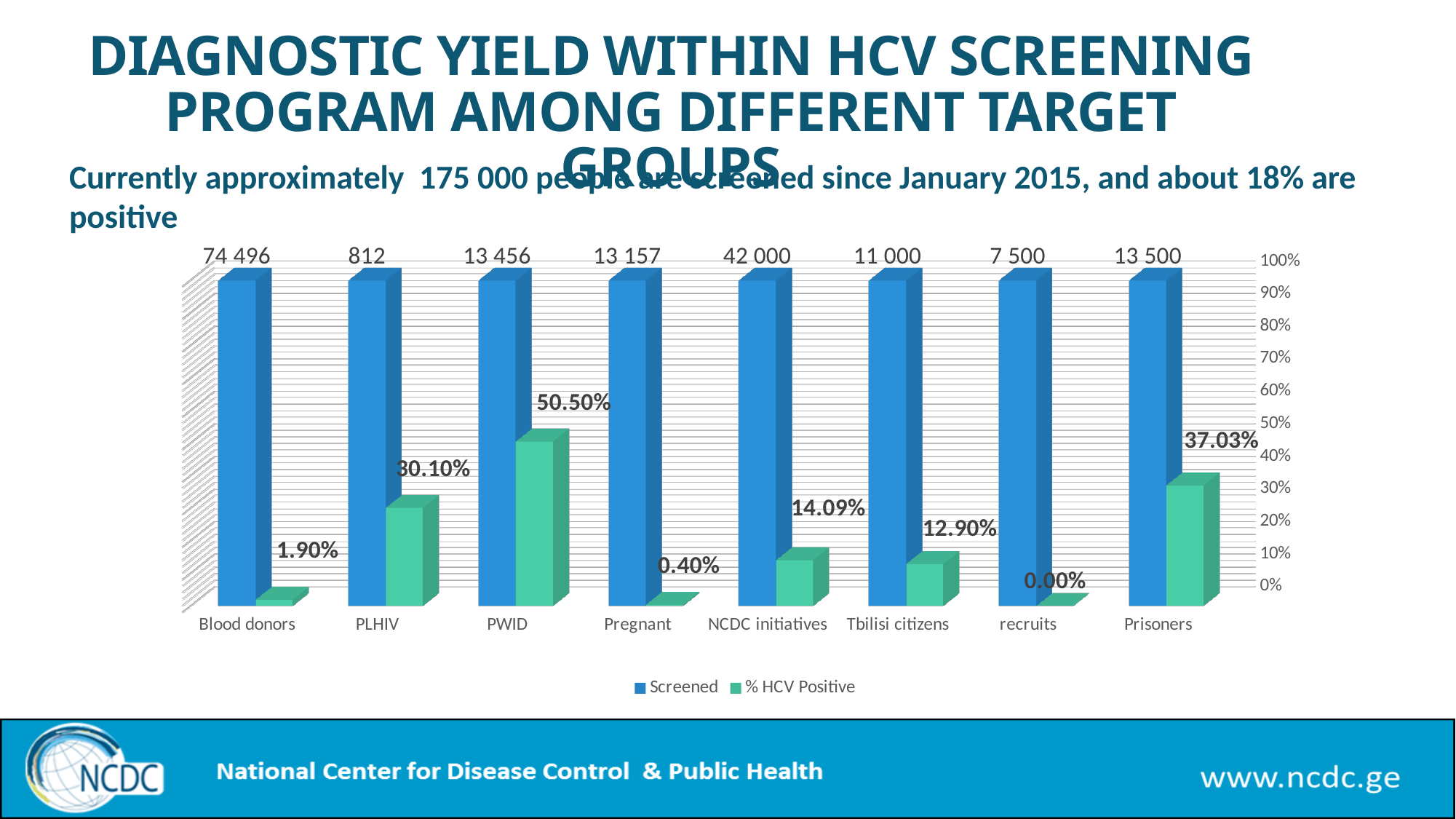
Which has a higher % HCV Positive, NCDC initiatives or Tbilisi citizens? NCDC initiatives Which target group has the smallest number screened? PLHIV Which target group has the highest % HCV Positive? PWID How many series does the legend list? 2 How many people were screened among Blood donors? 74 496 How many target groups are shown on the x axis? 8 What is the % HCV Positive value for Prisoners? 37.03% What is the % HCV Positive value for PWID? 50.50% Which target group has the lowest % HCV Positive? recruits What kind of chart is shown on the slide? Bar chart What is the difference in % HCV Positive between PWID and PLHIV? 20.40% How many people were screened in the NCDC initiatives group? 42 000